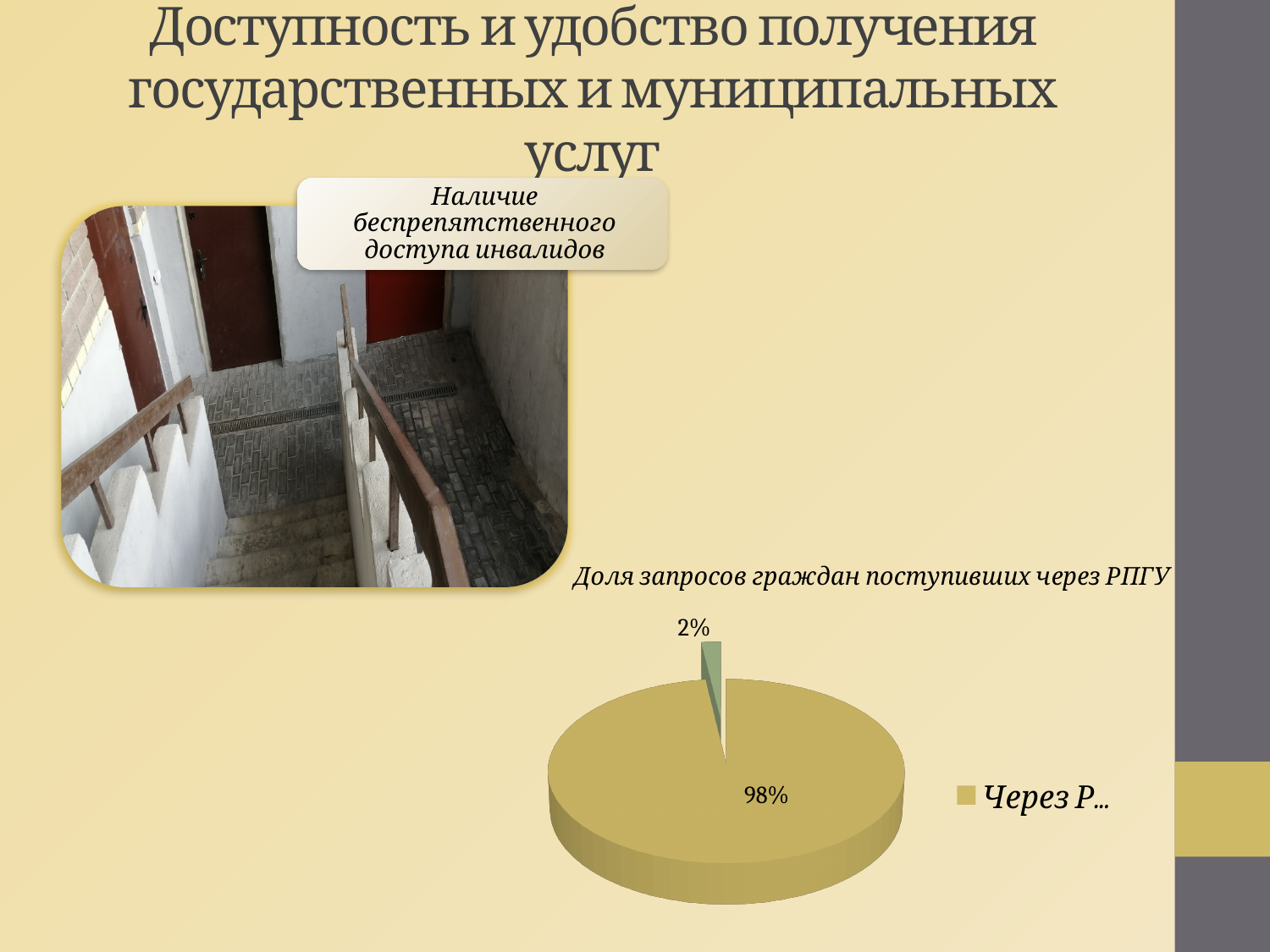
What share of the pie does the large gold slice represent? 98% What is the value of the largest slice in the pie chart? 98% What is the difference in percentage points between the two slices of the pie chart? 96 Which slice is larger in the pie chart, the one labelled 98% or the one labelled 2%? 98% What share of the pie does the small green slice represent? 2% Is the value of the largest slice in the pie chart greater or less than 50%? greater What kind of chart is shown on the slide? pie chart What is the value of the smallest slice in the pie chart? 2% Is the value of the smallest slice in the pie chart greater or less than 10%? less What is the title of the pie chart? Доля запросов граждан поступивших через РПГУ How many slices does the pie chart have? 2